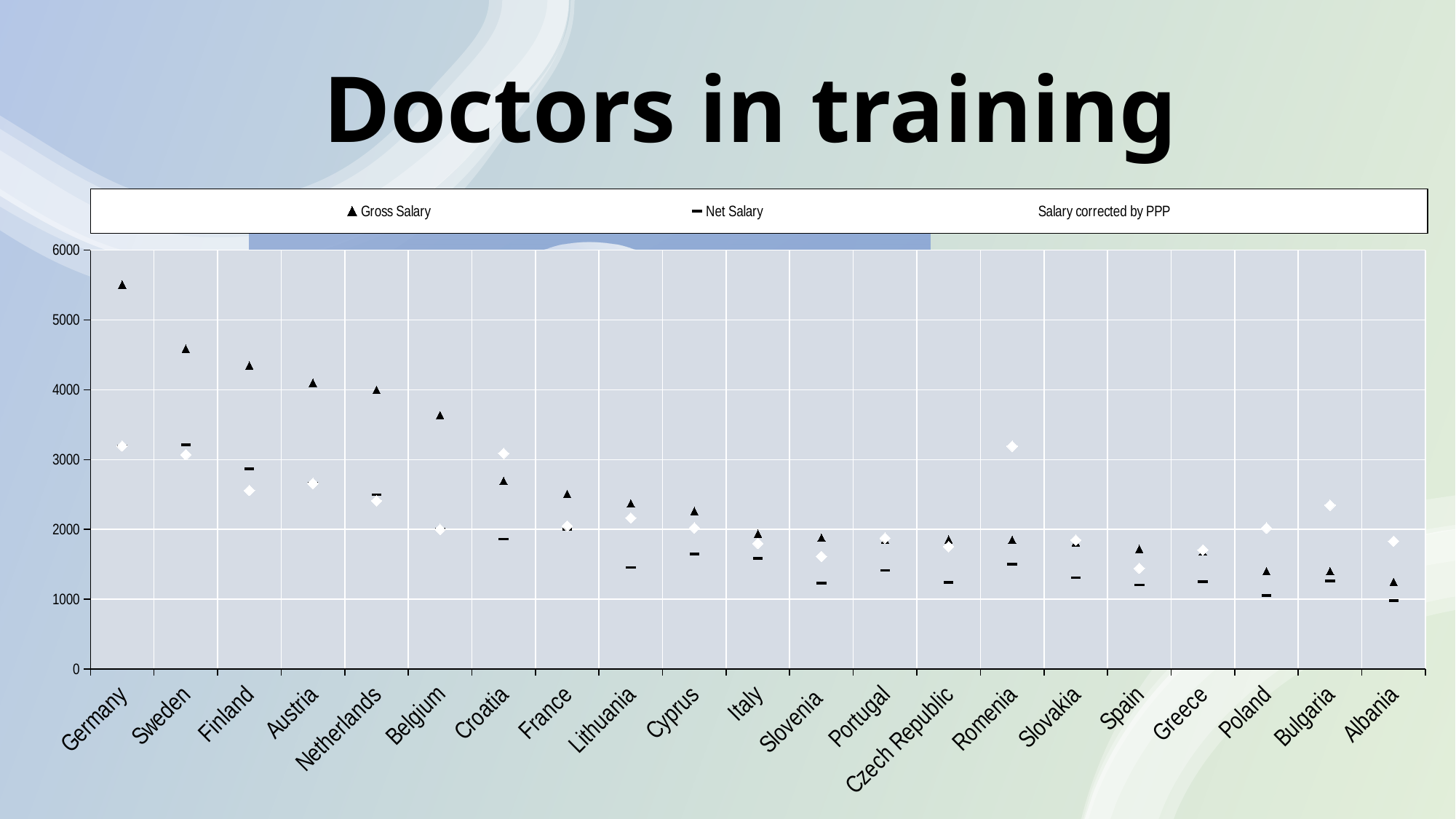
Which has the larger Salary corrected by PPP value, Romania or Slovakia? Romania What is the title of the slide containing the chart? Doctors in training Is the Net Salary value for Croatia greater or less than 2000? less Is the Gross Salary value for Germany greater or less than 5000? greater How many series does the chart legend list? 3 Which country has the highest Gross Salary in the chart? Germany Which country has the lowest Gross Salary in the chart? Albania How many countries are shown on the x axis of the chart? 21 Do the Gross Salary values generally rise or fall moving from left to right along the x axis? fall Which series are listed in the chart legend? Gross Salary, Net Salary, Salary corrected by PPP Is the Gross Salary value for Sweden greater or less than 4000? greater